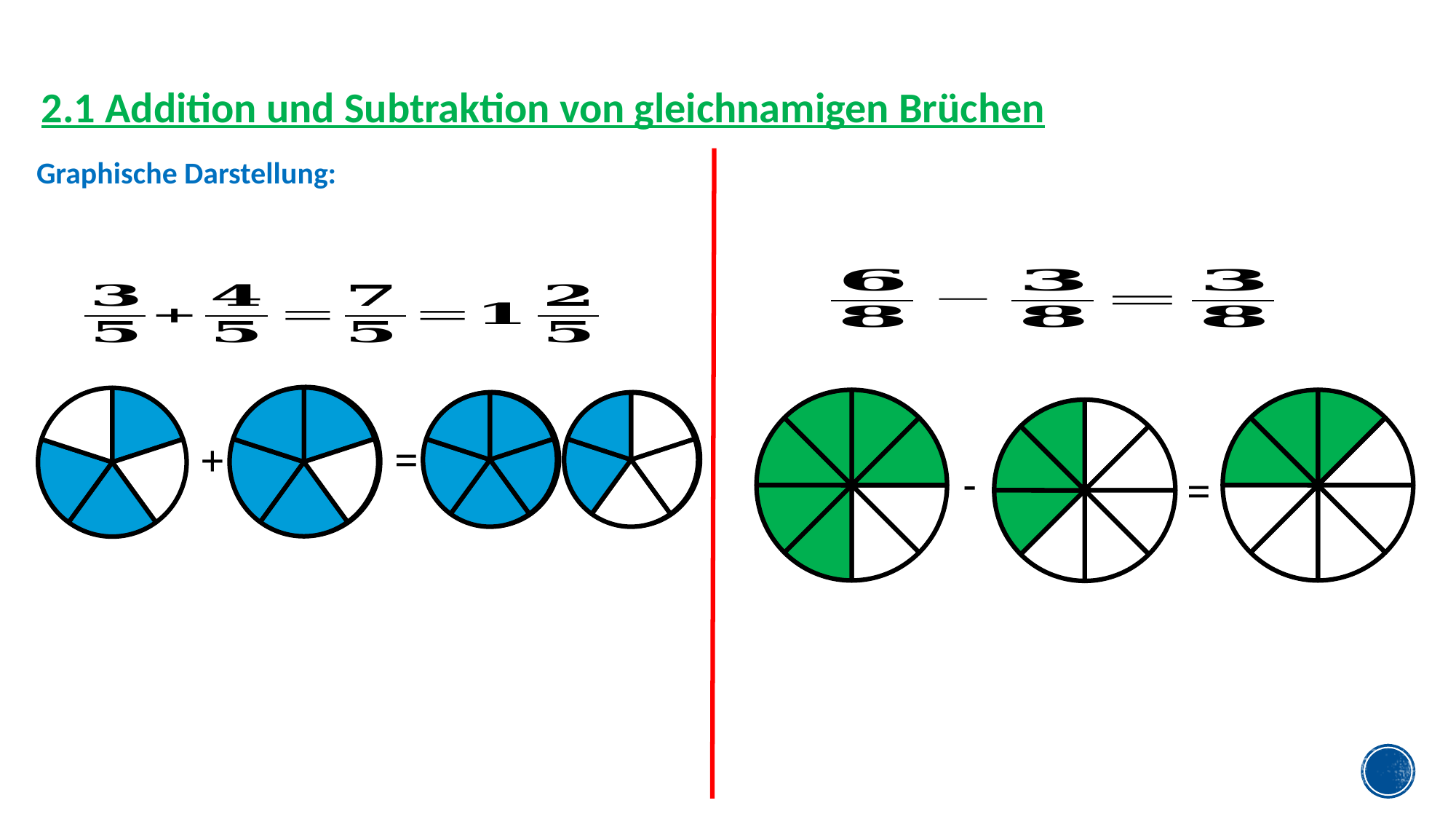
On the right side of the slide, how many parts of the first circle are shaded green? 6 On the left side of the slide, into how many equal parts is the first circle divided? 5 What colour are the shaded parts of the circles on the right side of the slide? green On the right side of the slide, how many parts of the last circle (after the = sign) are shaded green? 3 On the right side of the slide, into how many equal parts is each circle divided? 8 On the left side of the slide, what is the result of 3/5 + 4/5 as written in the equation? 7/5 = 1 2/5 On the left side of the slide, how many parts of the second circle (after the + sign) are shaded blue? 4 On the right side of the slide, what is the result of 6/8 − 3/8 as written in the equation? 3/8 Which has more shaded parts: the first circle on the left side or the first circle on the right side? the first circle on the right side On the left side of the slide, how many parts of the first circle are shaded blue? 3 On the left side of the slide, what fraction does the first circle represent according to the equation above it? 3/5 How many circle diagrams are shown on the left side of the slide? 4